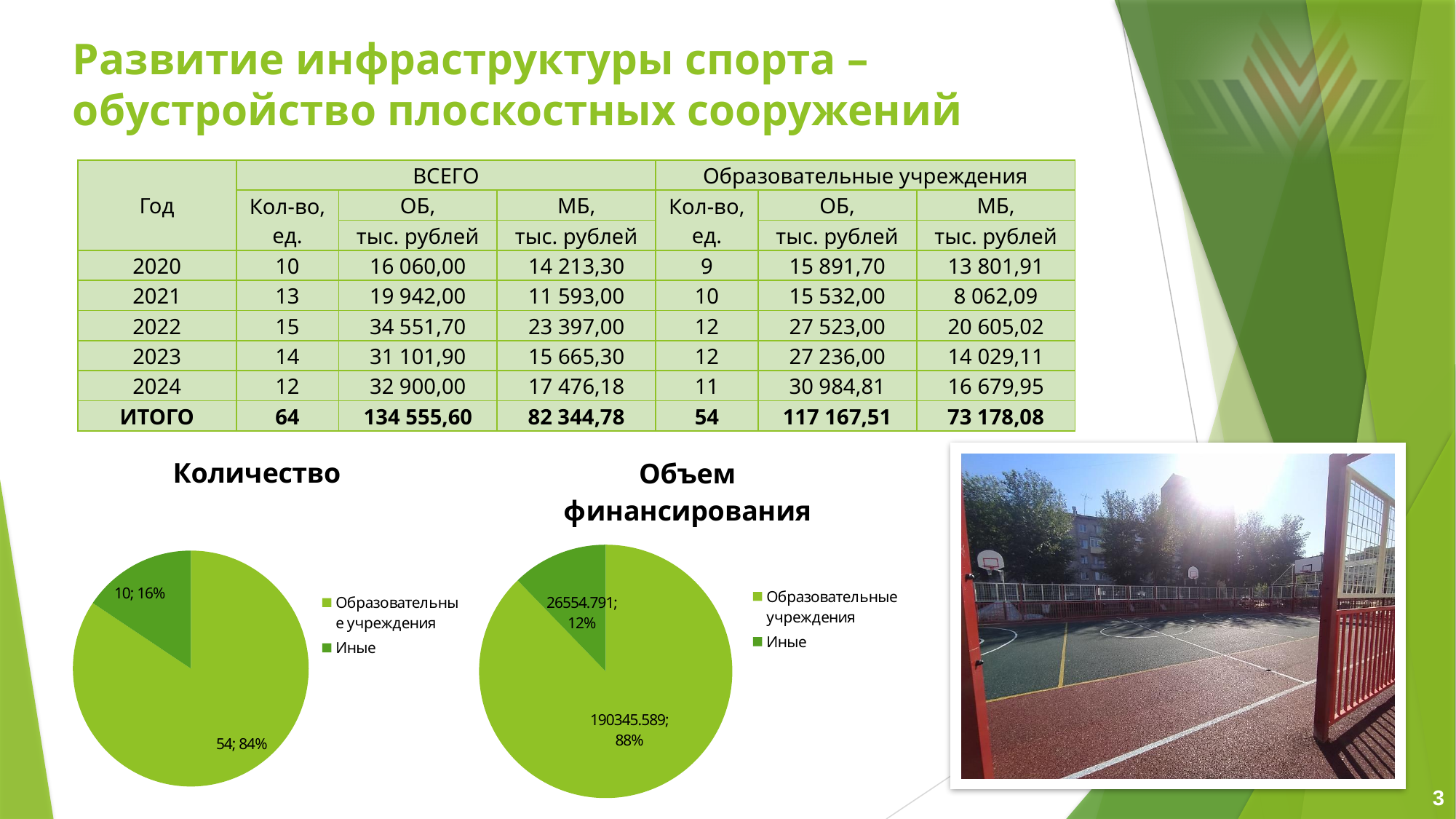
What kind of chart is the "Количество" chart? pie chart How many entries does the legend of the "Количество" chart list? 2 In the "Объем финансирования" chart, what value is shown for Иные? 26554.791; 12% In the "Объем финансирования" chart, what value is shown for Образовательные учреждения? 190345.589; 88% In the "Количество" chart, what is the difference between the Образовательные учреждения count and the Иные count? 44 In the "Объем финансирования" chart, which slice is the smallest? Иные In the "Количество" chart, what value is shown for Образовательные учреждения? 54; 84% In the "Количество" chart, what value is shown for Иные? 10; 16% In the "Количество" chart, which slice is the largest? Образовательные учреждения In the "Количество" chart, what share of the pie does Иные take? 16% In the "Объем финансирования" chart, what share of the pie does Образовательные учреждения take? 88% How many slices does the "Объем финансирования" pie chart have? 2